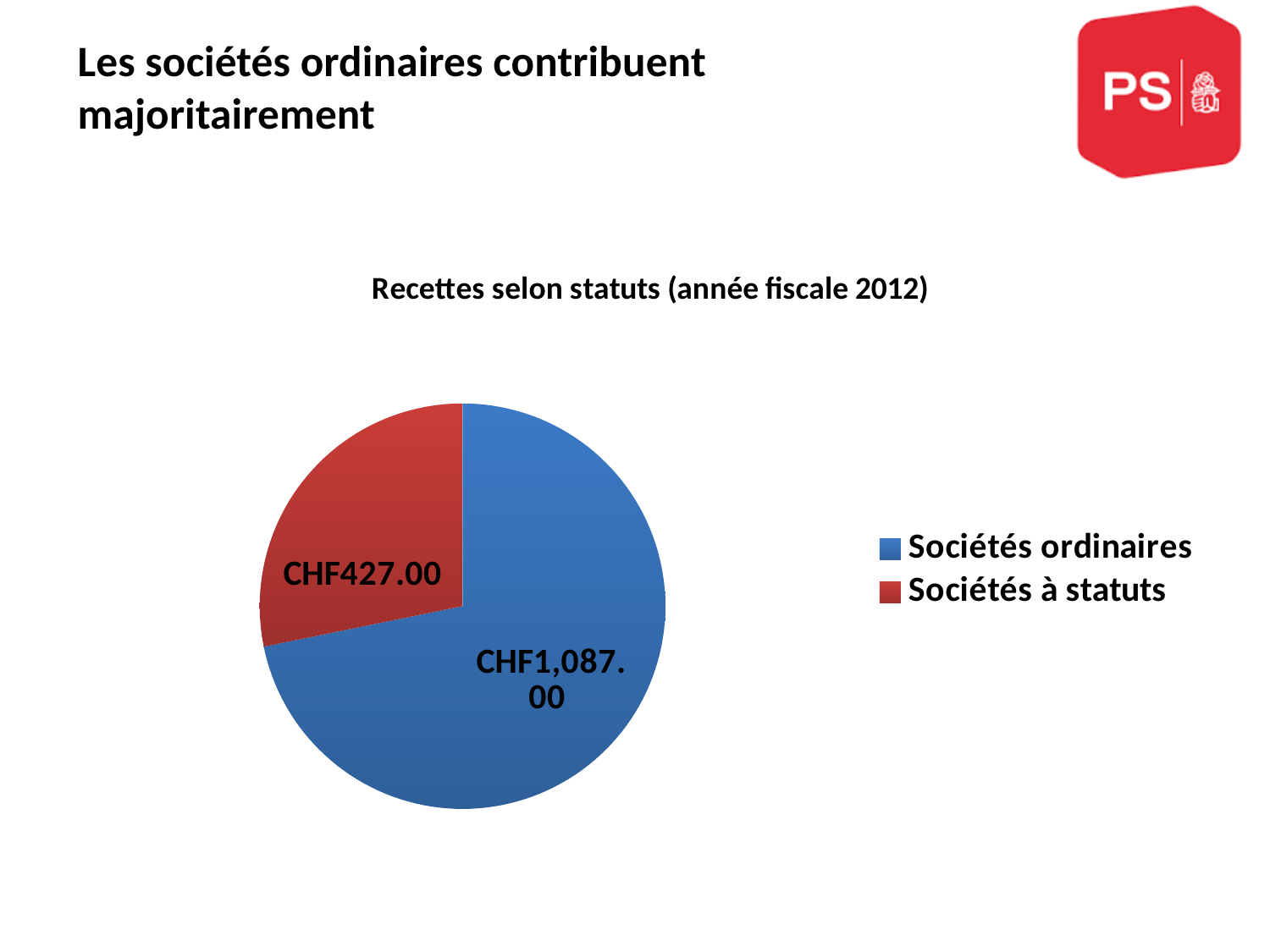
What colour is the slice for Sociétés à statuts? red Which category has the largest slice of the pie? Sociétés ordinaires How many categories are shown in the pie chart? 2 What is the value for Sociétés à statuts? CHF427.00 What is the total of the two slices in the pie chart? CHF1,514.00 What is the value for Sociétés ordinaires? CHF1,087.00 What is the title of the chart? Recettes selon statuts (année fiscale 2012) Which category has the smallest slice of the pie? Sociétés à statuts Which is larger, the value for Sociétés ordinaires or the value for Sociétés à statuts? Sociétés ordinaires What type of chart is shown on the slide? pie chart What is the difference between the value for Sociétés ordinaires and the value for Sociétés à statuts? CHF660.00